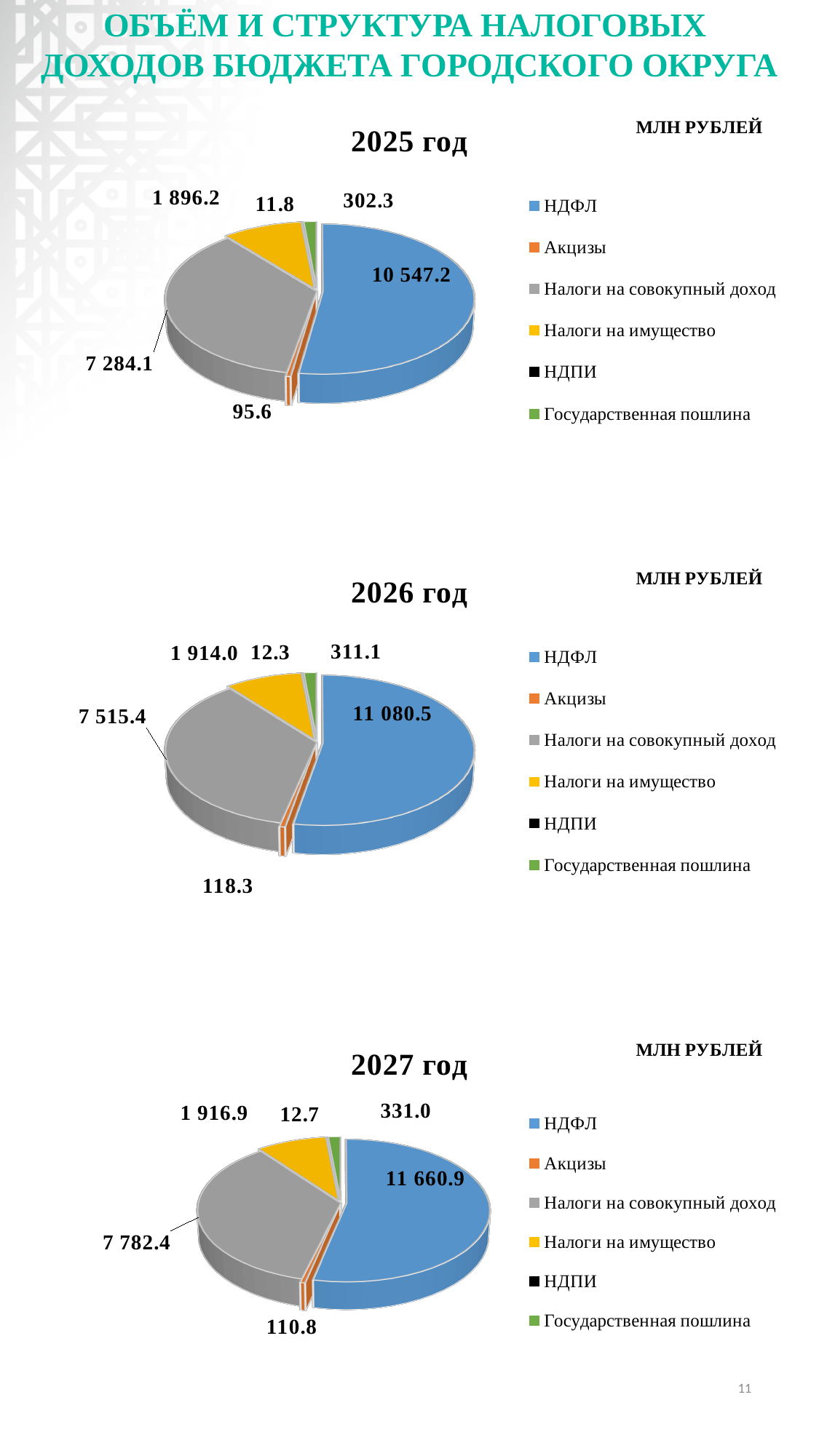
What unit is stated above the legend of each chart? МЛН РУБЛЕЙ What is the difference between the НДФЛ value in the 2027 год chart and the НДФЛ value in the 2025 год chart? 1 113.7 In the 2025 год chart, which is larger: Налоги на имущество or Государственная пошлина? Налоги на имущество In the 2027 год chart, what is the value for Государственная пошлина? 331.0 What type of chart is the 2026 год chart? Pie chart In the 2025 год chart, which category has the largest value? НДФЛ In the 2026 год chart, what is the difference between НДФЛ and Налоги на совокупный доход? 3 565.1 In the 2026 год chart, what is the value for Налоги на совокупный доход? 7 515.4 In the 2025 год chart, what is the value for НДФЛ? 10 547.2 In the 2027 год chart, what is the value for Акцизы? 110.8 How many categories does the legend of the 2027 год chart list? 6 In the 2026 год chart, which category has the smallest value? НДПИ